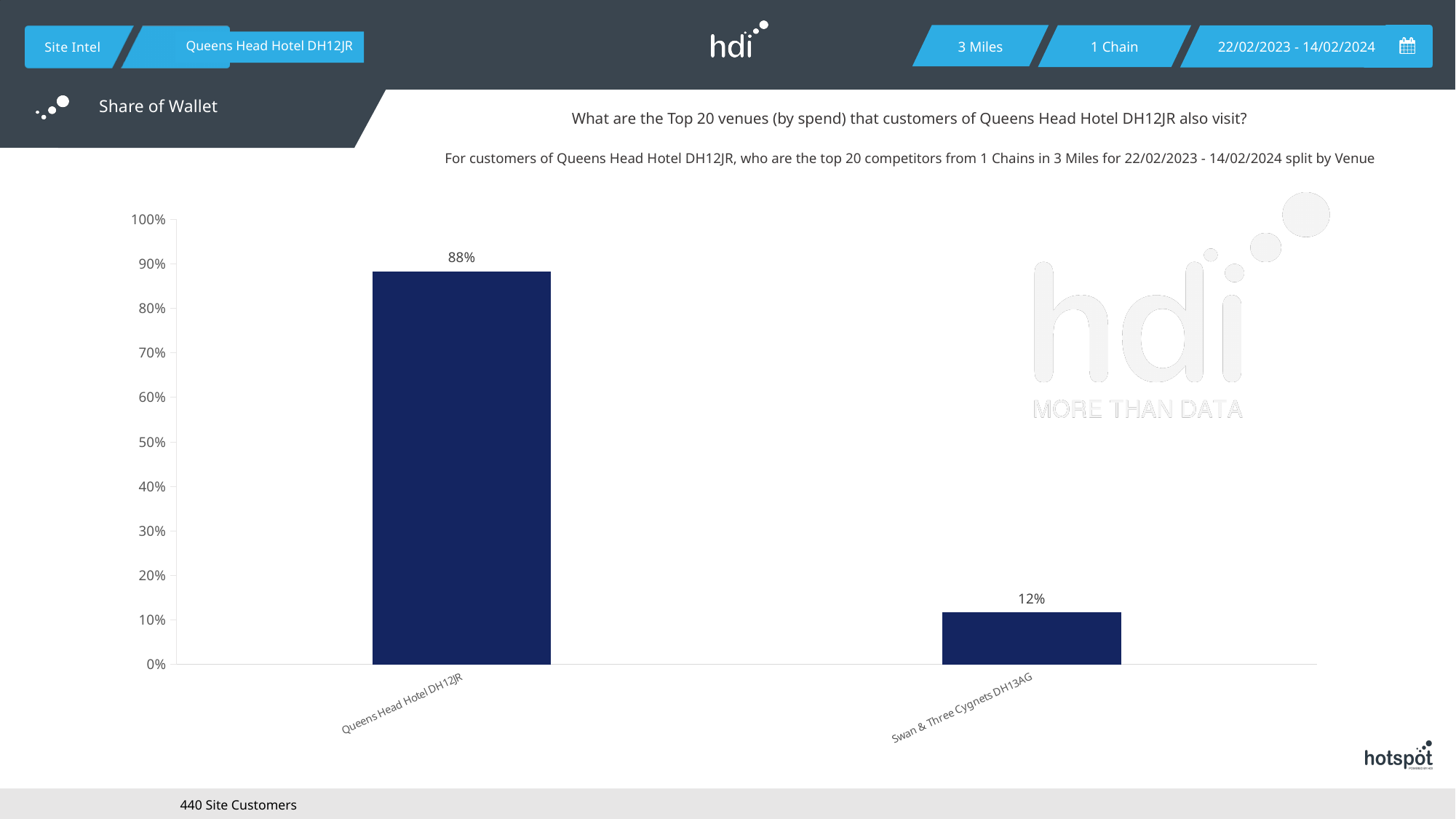
What is the value for Swan & Three Cygnets DH13AG? 12% What is the difference between the values for Queens Head Hotel DH12JR and Swan & Three Cygnets DH13AG? 76% How many venues are shown on the chart? 2 Which venue has the highest value? Queens Head Hotel DH12JR Which is larger, the value for Queens Head Hotel DH12JR or for Swan & Three Cygnets DH13AG? Queens Head Hotel DH12JR What is the value for Queens Head Hotel DH12JR? 88% Which venue has the lowest value? Swan & Three Cygnets DH13AG What is the total of the two values shown on the chart? 100% Is the value for Queens Head Hotel DH12JR greater or less than 80%? greater What is the highest value shown on the vertical axis? 100% What kind of chart is shown on the slide? bar chart Is the value for Swan & Three Cygnets DH13AG greater or less than 20%? less